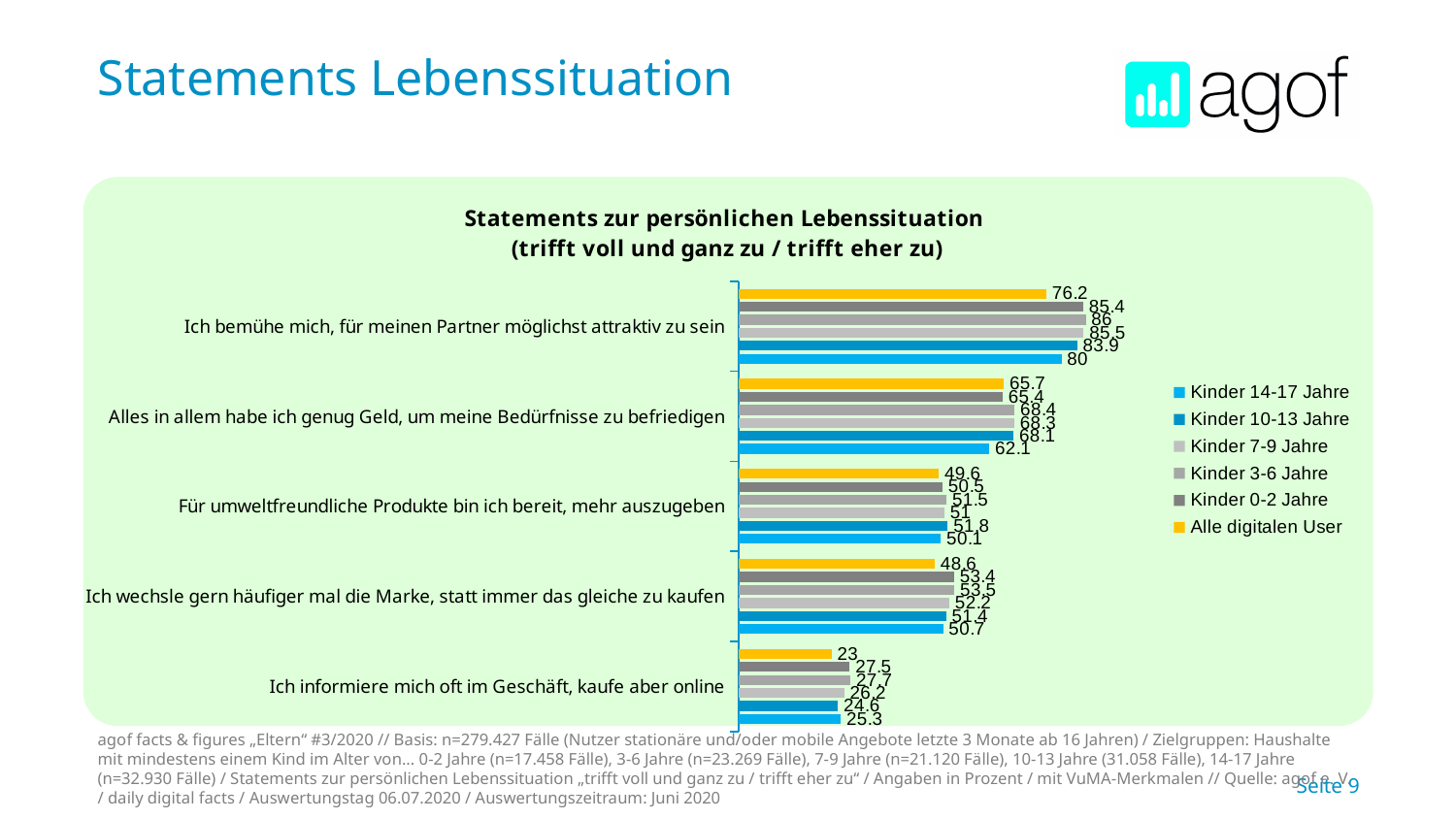
What is the value for 'Alle digitalen User' for the statement 'Ich bemühe mich, für meinen Partner möglichst attraktiv zu sein'? 76.2 What is the value for 'Alle digitalen User' for the statement 'Ich informiere mich oft im Geschäft, kaufe aber online'? 23 What kind of chart is shown on the slide? bar chart Which colour represents 'Alle digitalen User' in the legend? yellow For 'Alle digitalen User', which statement has the highest value? Ich bemühe mich, für meinen Partner möglichst attraktiv zu sein What is the value for 'Kinder 14-17 Jahre' for the statement 'Ich informiere mich oft im Geschäft, kaufe aber online'? 25.3 For 'Alle digitalen User', which statement has the lowest value? Ich informiere mich oft im Geschäft, kaufe aber online How many series does the legend list? 6 For 'Alle digitalen User', which statement has the larger value: 'Alles in allem habe ich genug Geld, um meine Bedürfnisse zu befriedigen' or 'Für umweltfreundliche Produkte bin ich bereit, mehr auszugeben'? Alles in allem habe ich genug Geld, um meine Bedürfnisse zu befriedigen What is the value for 'Kinder 14-17 Jahre' for the statement 'Alles in allem habe ich genug Geld, um meine Bedürfnisse zu befriedigen'? 62.1 For the statement 'Ich bemühe mich, für meinen Partner möglichst attraktiv zu sein', what is the difference between the value for 'Kinder 14-17 Jahre' and the value for 'Alle digitalen User'? 3.8 How many statements (categories) are plotted in the chart? 5